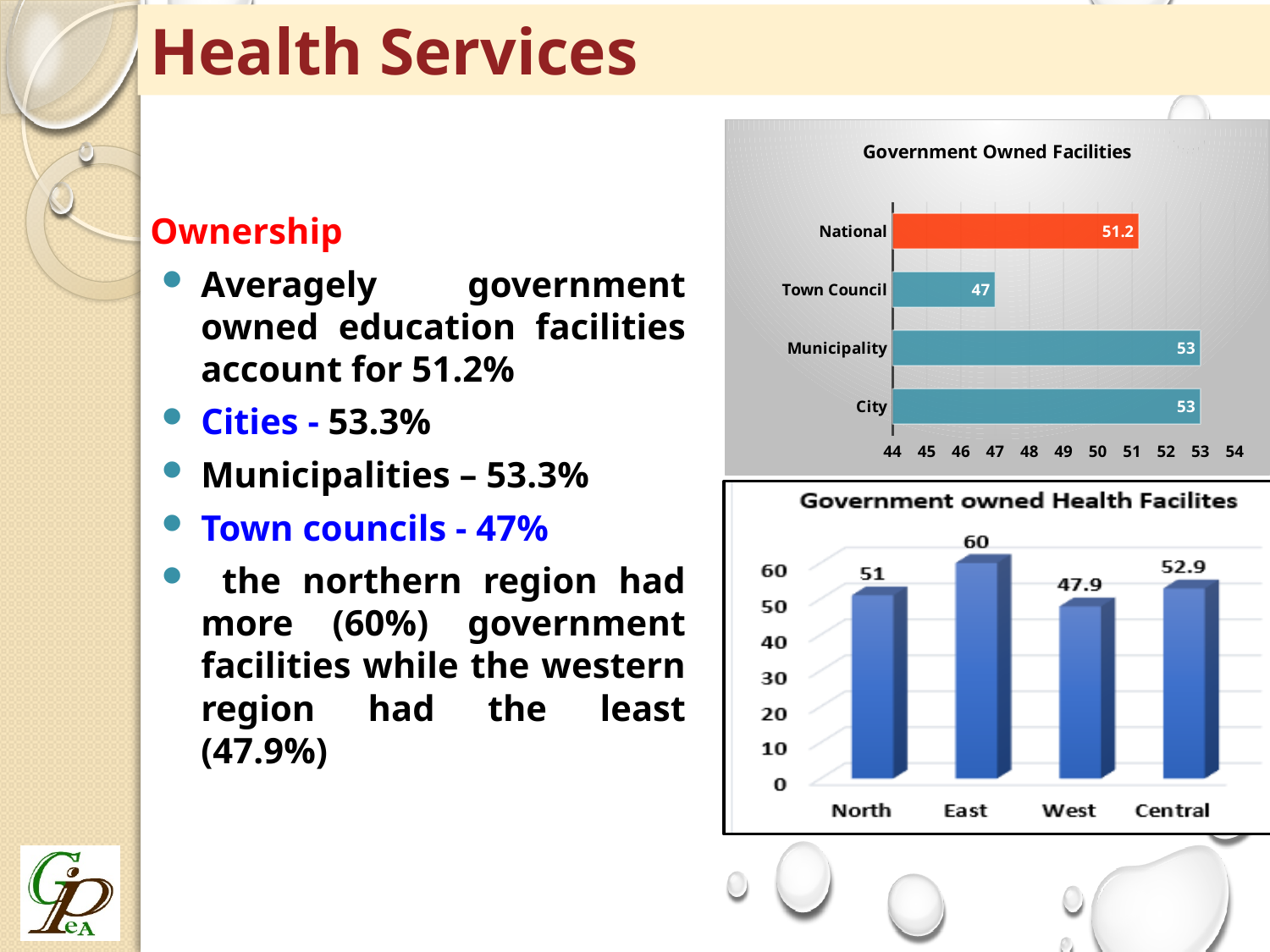
In the 'Government owned Health Facilites' chart, what is the difference between the East value and the West value? 12.1 In the 'Government owned Health Facilites' chart, what is the value for East? 60 In the 'Government owned Health Facilites' chart, which region has the lowest value? West In the 'Government Owned Facilities' chart, what is the difference between the Municipality value and the Town Council value? 6 In the 'Government owned Health Facilites' chart, what is the value for West? 47.9 In the 'Government Owned Facilities' chart, which category has the lowest value? Town Council What kind of chart is the 'Government owned Health Facilites' chart? Bar chart In the 'Government Owned Facilities' chart, what is the value for National? 51.2 In the 'Government Owned Facilities' chart, what is the value for Town Council? 47 In the 'Government owned Health Facilites' chart, which region has the highest value? East In the 'Government Owned Facilities' chart, how many categories are shown? 4 In the 'Government Owned Facilities' chart, which bar is shown in a different colour (orange) from the others? National